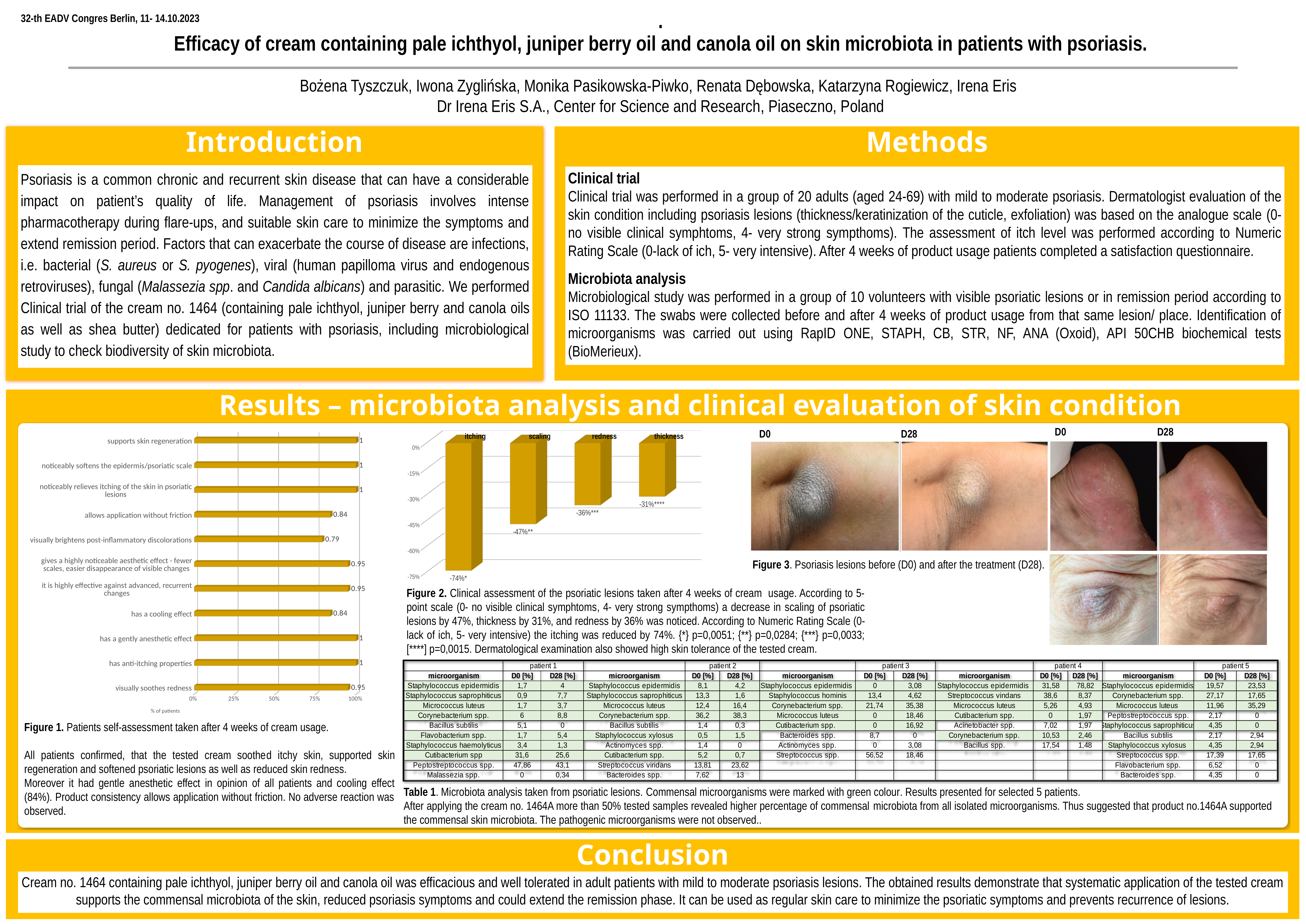
In Figure 1 (the horizontal bar chart on the left), what is the difference between the values for "visually soothes redness" and "allows application without friction"? 0.11 What kind of chart is Figure 1 (the chart on the left)? bar chart In Figure 2 (the chart of itching, scaling, redness and thickness), how many categories are plotted? 4 In Figure 2 (the chart of itching, scaling, redness and thickness), which category shows the largest decrease? itching In Figure 1 (the horizontal bar chart on the left), which category has the lowest value? visually brightens post-inflammatory discolorations In Figure 1 (the horizontal bar chart on the left), how many categories are plotted? 11 In Figure 1 (the horizontal bar chart on the left), what is the value for "has a cooling effect"? 0.84 In Figure 2 (the chart of itching, scaling, redness and thickness), what is the value for thickness? -31% In Figure 2 (the chart of itching, scaling, redness and thickness), what is the value for scaling? -47% In Figure 2 (the chart of itching, scaling, redness and thickness), what is the difference between the values for itching and redness? 38% In Figure 1 (the horizontal bar chart on the left), what is the value for "visually brightens post-inflammatory discolorations"? 0.79 In Figure 1 (the horizontal bar chart on the left), which is larger: the value for "has a cooling effect" or the value for "has anti-itching properties"? has anti-itching properties